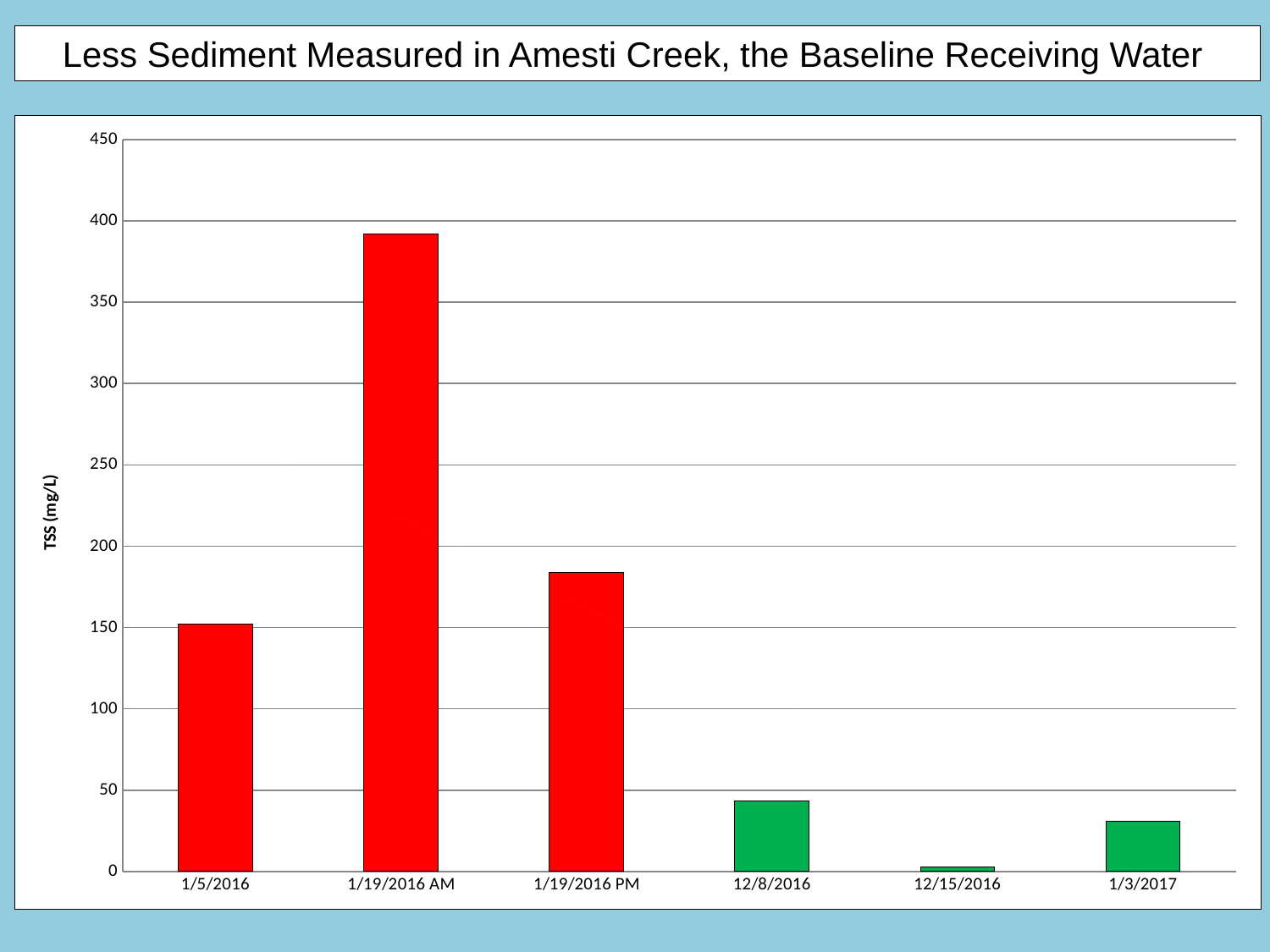
Which is larger, the value for 12/8/2016 or the value for 1/3/2017? 12/8/2016 Is the value for 12/8/2016 greater or less than 50? less Which is larger, the value for 1/5/2016 or the value for 1/19/2016 PM? 1/19/2016 PM Is the value for 1/5/2016 greater or less than 200? less Is the value for 1/19/2016 AM greater or less than 350? greater Which date has the highest TSS value? 1/19/2016 AM What is the label on the vertical axis? TSS (mg/L) What kind of chart is shown on the slide? bar chart Which date has the lowest TSS value? 12/15/2016 What colour are the bars for the 2016 December and 2017 dates (12/8/2016, 12/15/2016, 1/3/2017)? green How many bars (dates) are plotted on the chart? 6